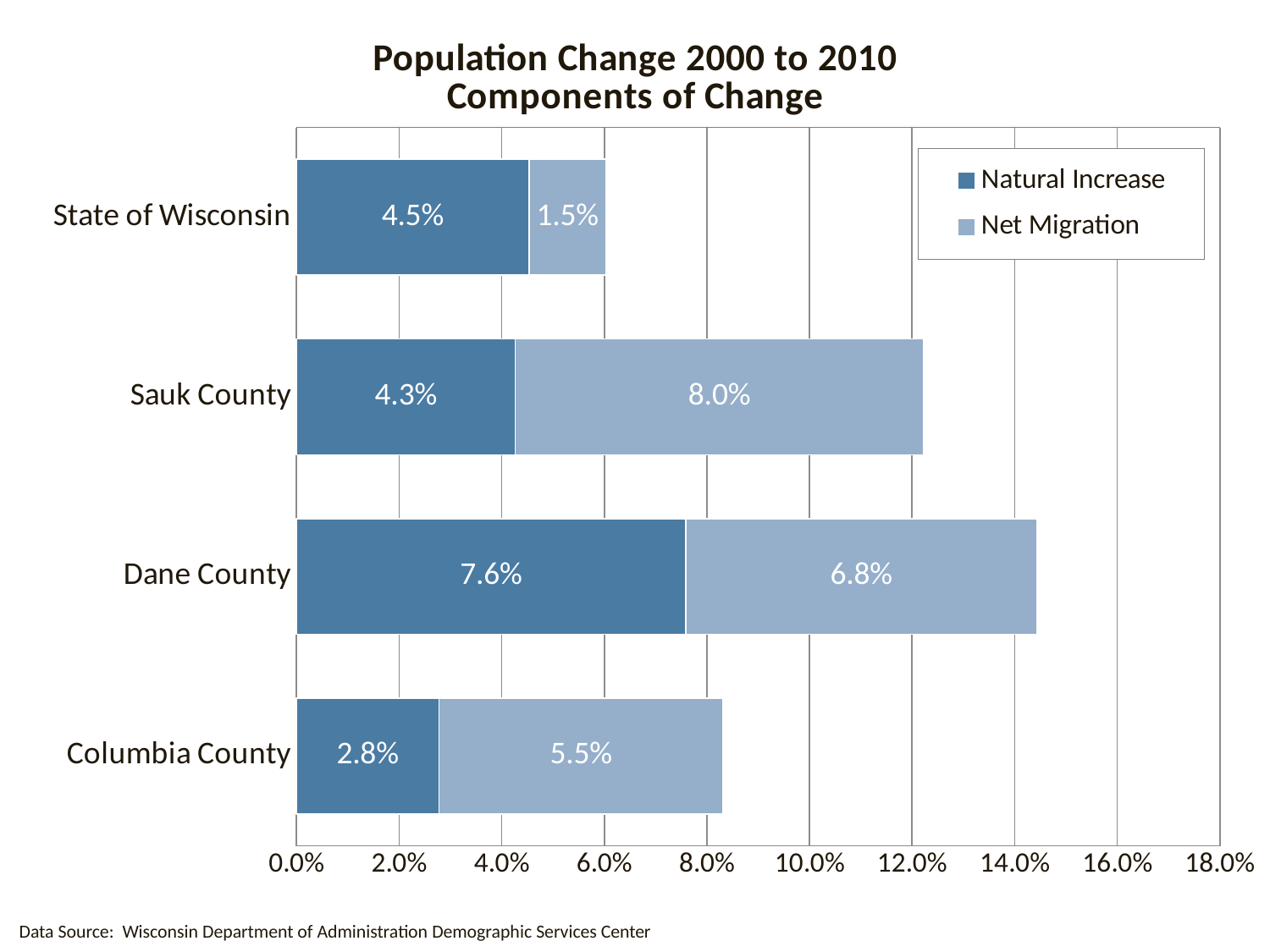
What is the title of the chart? Population Change 2000 to 2010 Components of Change What is the Net Migration value for the State of Wisconsin? 1.5% What is the Natural Increase value for Dane County? 7.6% What is the Net Migration value for Sauk County? 8.0% Which category has the lowest Net Migration value? State of Wisconsin What is the total of the stacked bar for Dane County? 14.4% Which category has the highest Natural Increase value? Dane County How many categories are shown on the chart? 4 What kind of chart is shown on the slide? Stacked bar chart Which is larger: the Natural Increase for Columbia County or the Natural Increase for Sauk County? Sauk County What is the difference between the Net Migration values for Sauk County and Columbia County? 2.5% How many series does the legend list? 2